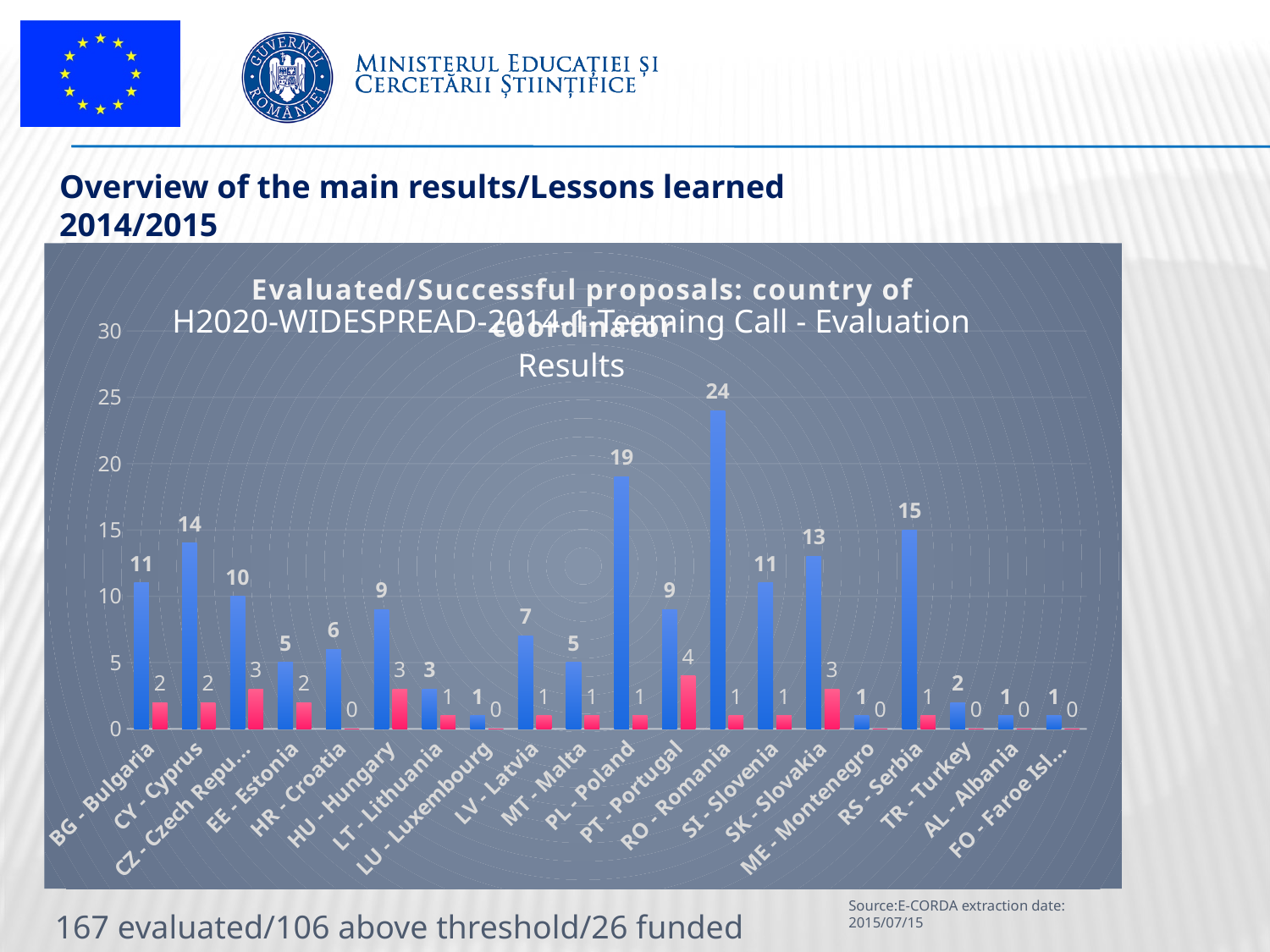
What is the value of the blue (evaluated) bar for RO - Romania? 24 Which has more evaluated proposals (blue bar): CY - Cyprus or SK - Slovakia? CY - Cyprus How many countries are shown on the x axis of the chart? 20 Is the evaluated (blue) value for RS - Serbia greater or less than 10? greater What is the value of the pink (successful) bar for PT - Portugal? 4 What is the difference between the evaluated proposals for RO - Romania and PL - Poland? 5 What is the value of the blue (evaluated) bar for SK - Slovakia? 13 Which country has the highest number of successful proposals (pink bar)? PT - Portugal Which country has the highest number of evaluated proposals (blue bar)? RO - Romania What is the value of the blue (evaluated) bar for PL - Poland? 19 What kind of chart is shown on the slide? Bar chart What colour are the bars showing the evaluated proposals (the taller bars)? Blue